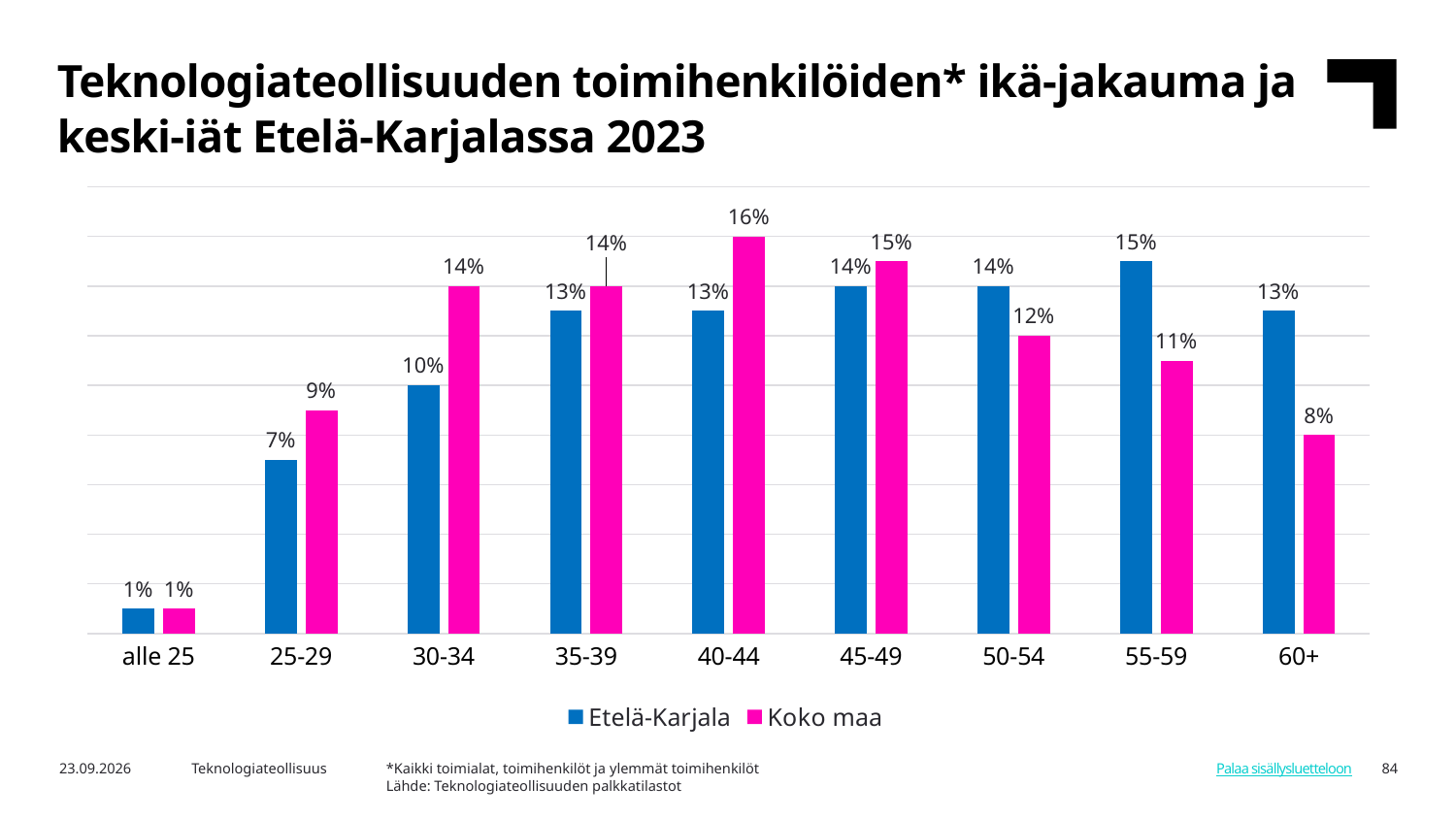
What is the value for Koko maa in the 40-44 age group? 16% In the 30-34 age group, which series has the larger value, Etelä-Karjala or Koko maa? Koko maa What kind of chart is shown on the slide? Bar chart What is the value for Etelä-Karjala in the 25-29 age group? 7% Which colour represents the Koko maa series? Magenta (pink) Which age group has the highest value for Koko maa? 40-44 How many series does the legend list? 2 What is the difference between Koko maa and Etelä-Karjala in the 60+ age group? 5 percentage points What is the value for Etelä-Karjala in the 55-59 age group? 15% How many age groups are shown on the x axis? 9 Which age group has the lowest value for Etelä-Karjala? alle 25 In the 55-59 age group, which series has the larger value, Etelä-Karjala or Koko maa? Etelä-Karjala